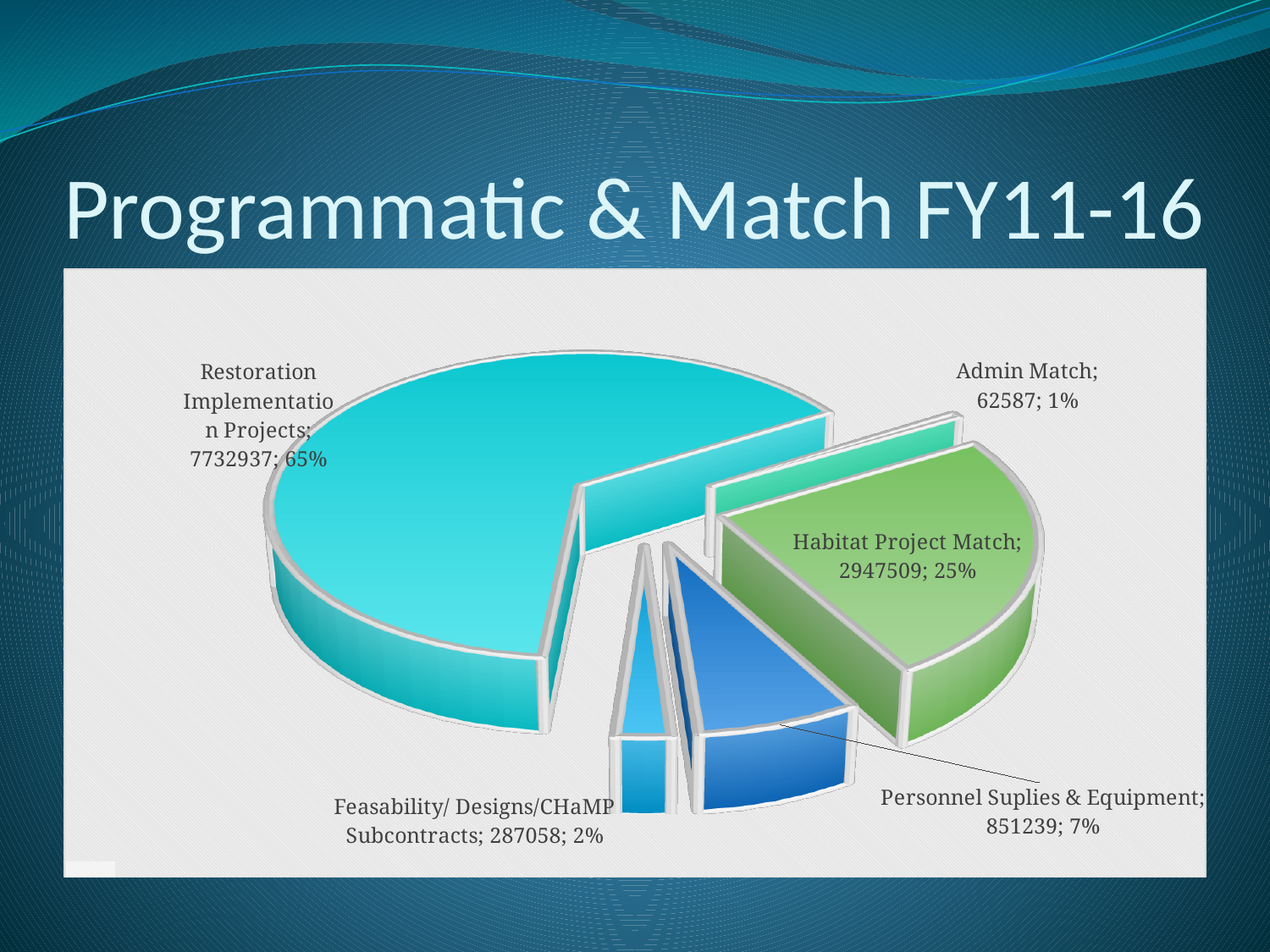
What kind of chart is shown on the slide? Pie chart What is the value for Feasability/ Designs/CHaMP Subcontracts? 287058 What is the title of the slide? Programmatic & Match FY11-16 What is the difference between the values for Habitat Project Match and Personnel Suplies & Equipment? 2096270 What share of the pie is Habitat Project Match? 25% What is the value for Personnel Suplies & Equipment? 851239 What share of the pie is Admin Match? 1% Which category has the smallest slice? Admin Match How many slices does the pie chart have? 5 Which is larger, Habitat Project Match or Personnel Suplies & Equipment? Habitat Project Match Which category has the largest slice? Restoration Implementation Projects What is the value for Restoration Implementation Projects? 7732937